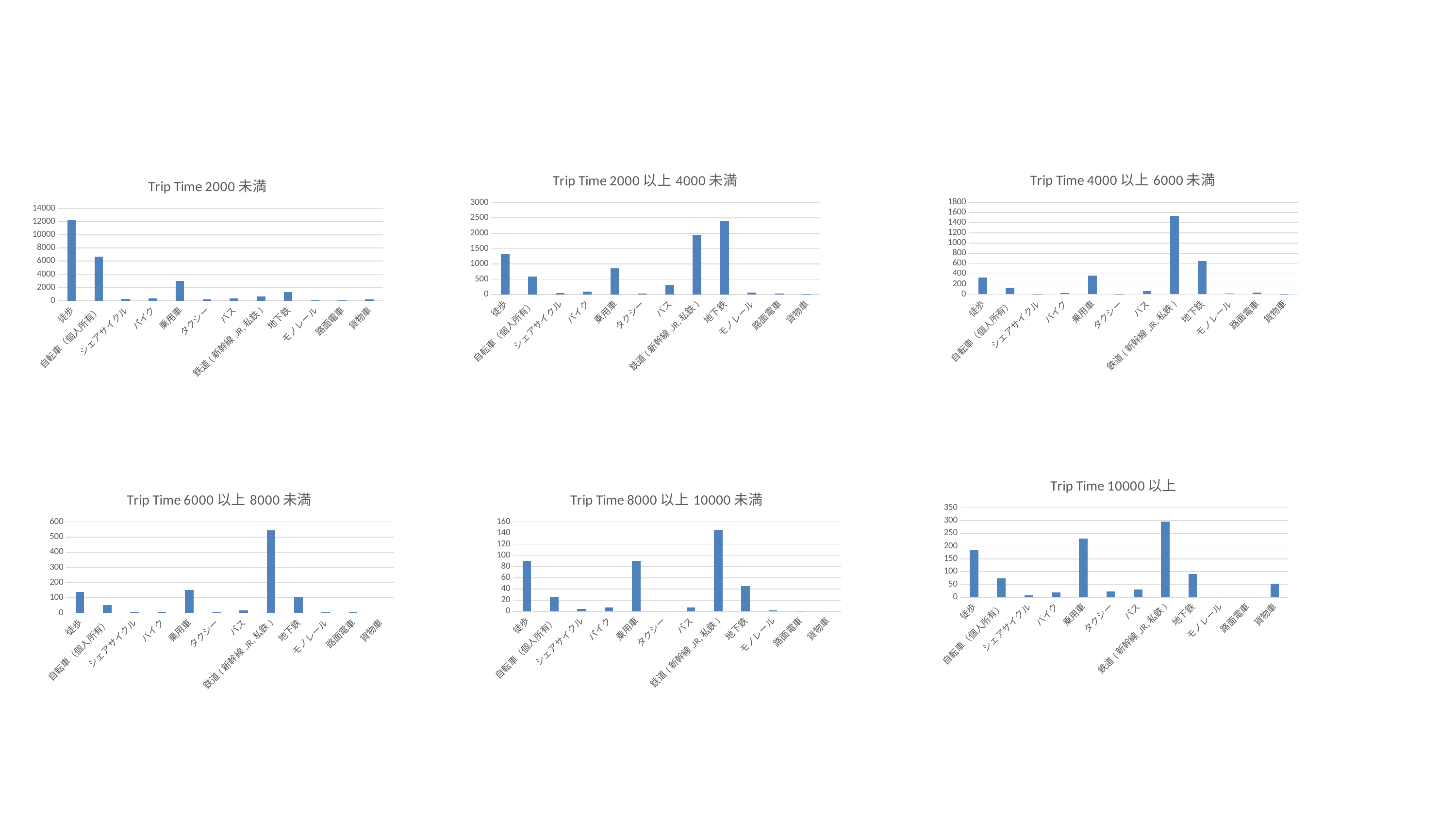
What kind of chart is the chart titled "Trip Time 10000 以上"? bar chart In the chart titled "Trip Time 10000 以上", which is larger, the value for 徒歩 or the value for 乗用車? 乗用車 In the chart titled "Trip Time 10000 以上", which category has the highest value? 鉄道（新幹線, JR, 私鉄） In the chart titled "Trip Time 2000 未満", which category has the highest value? 徒歩 In the chart titled "Trip Time 2000 以上 4000 未満", which category has the highest value? 地下鉄 In the chart titled "Trip Time 2000 以上 4000 未満", is the value for 徒歩 greater or less than 1000? greater In the chart titled "Trip Time 2000 未満", is the value for 徒歩 greater or less than 10000? greater In the chart titled "Trip Time 8000 以上 10000 未満", which is larger, the value for 地下鉄 or the value for 自転車（個人所有）? 地下鉄 How many categories are shown on the x axis of the chart titled "Trip Time 2000 未満"? 12 In the chart titled "Trip Time 6000 以上 8000 未満", is the value for 鉄道（新幹線, JR, 私鉄） greater or less than 500? greater